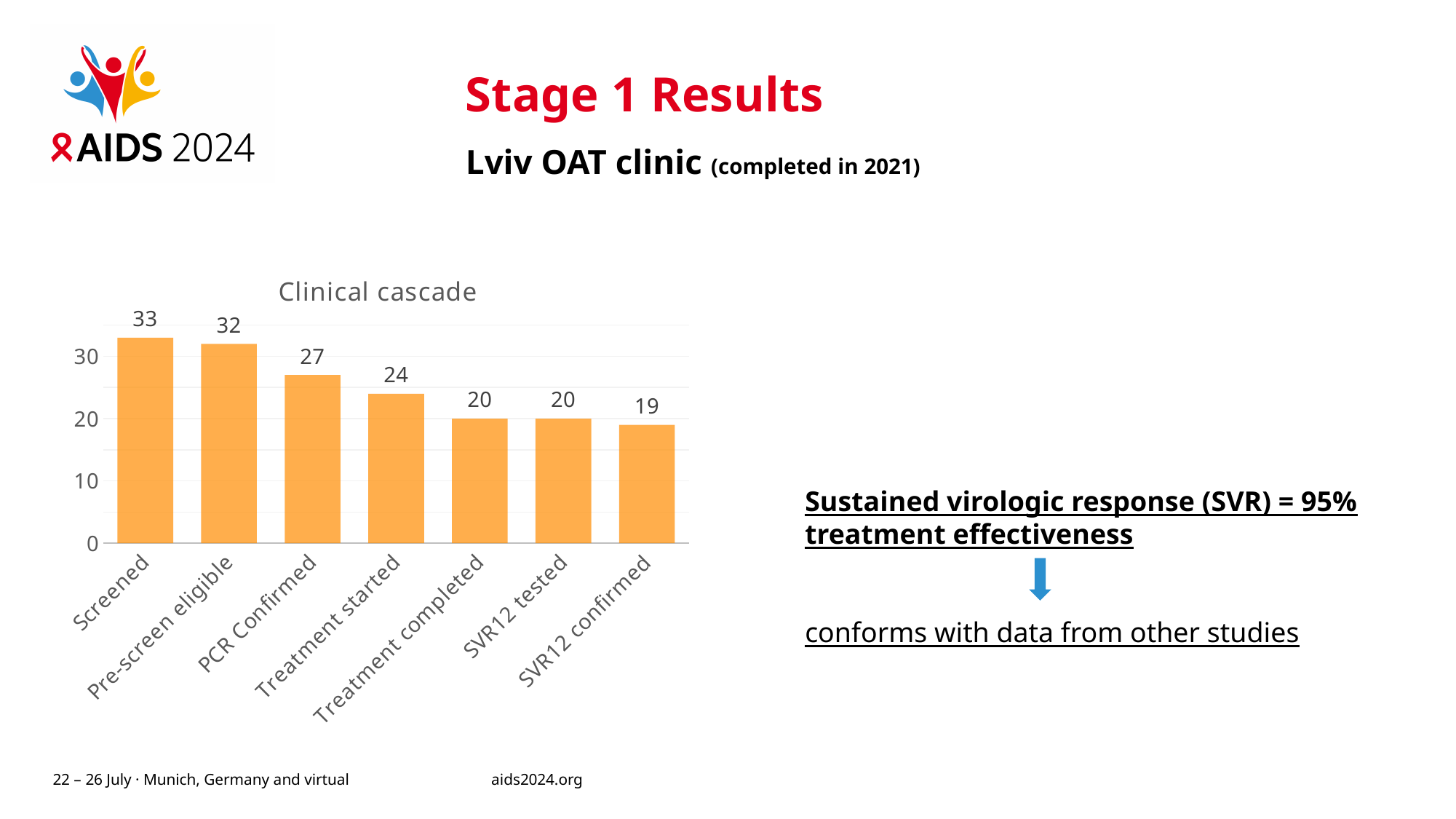
Do the values in the Clinical cascade chart generally rise or fall from left to right? Fall What is the value for PCR Confirmed in the Clinical cascade chart? 27 Which is larger, the value for Pre-screen eligible or the value for Treatment completed? Pre-screen eligible Which category has the lowest value in the Clinical cascade chart? SVR12 confirmed What is the difference between the values for Screened and SVR12 confirmed? 14 How many categories are shown in the Clinical cascade chart? 7 What is the difference between the values for PCR Confirmed and Treatment started? 3 What kind of chart is the Clinical cascade chart? Bar chart Which category has the highest value in the Clinical cascade chart? Screened What is the value for Treatment started in the Clinical cascade chart? 24 What is the value for SVR12 confirmed in the Clinical cascade chart? 19 What is the value for Screened in the Clinical cascade chart? 33